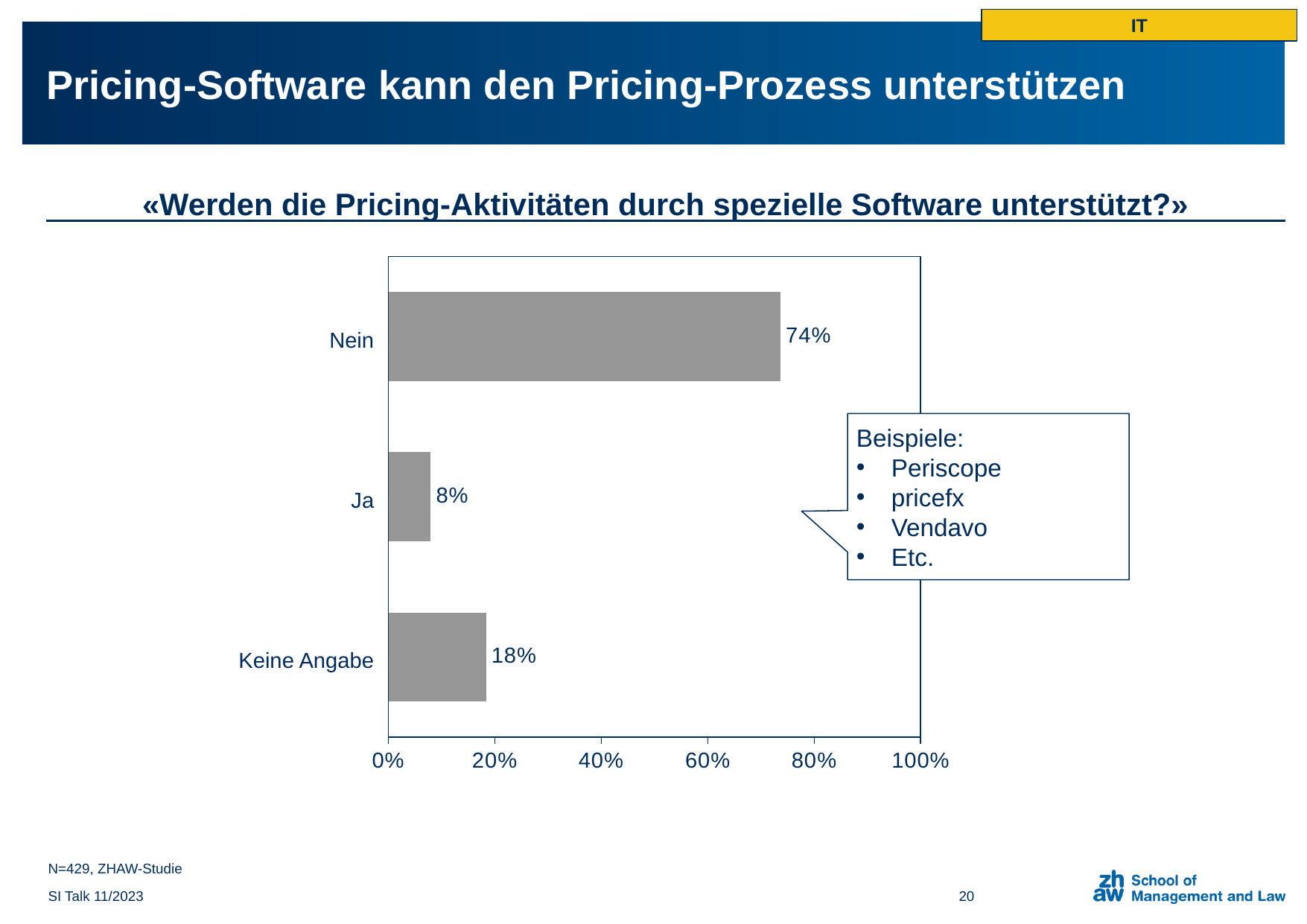
What is the value for "Ja"? 8% What is the value for "Nein"? 74% What is the difference between the values for "Nein" and "Ja"? 66% Which category has the highest value? Nein Is the value for "Nein" greater or less than 60%? greater What is the value for "Keine Angabe"? 18% What is the maximum value shown on the x axis of the chart? 100% Which is larger, the value for "Keine Angabe" or the value for "Ja"? Keine Angabe What is the difference between the values for "Keine Angabe" and "Ja"? 10% What kind of chart is shown on the slide? bar chart Which category has the lowest value? Ja How many categories are shown in the chart? 3